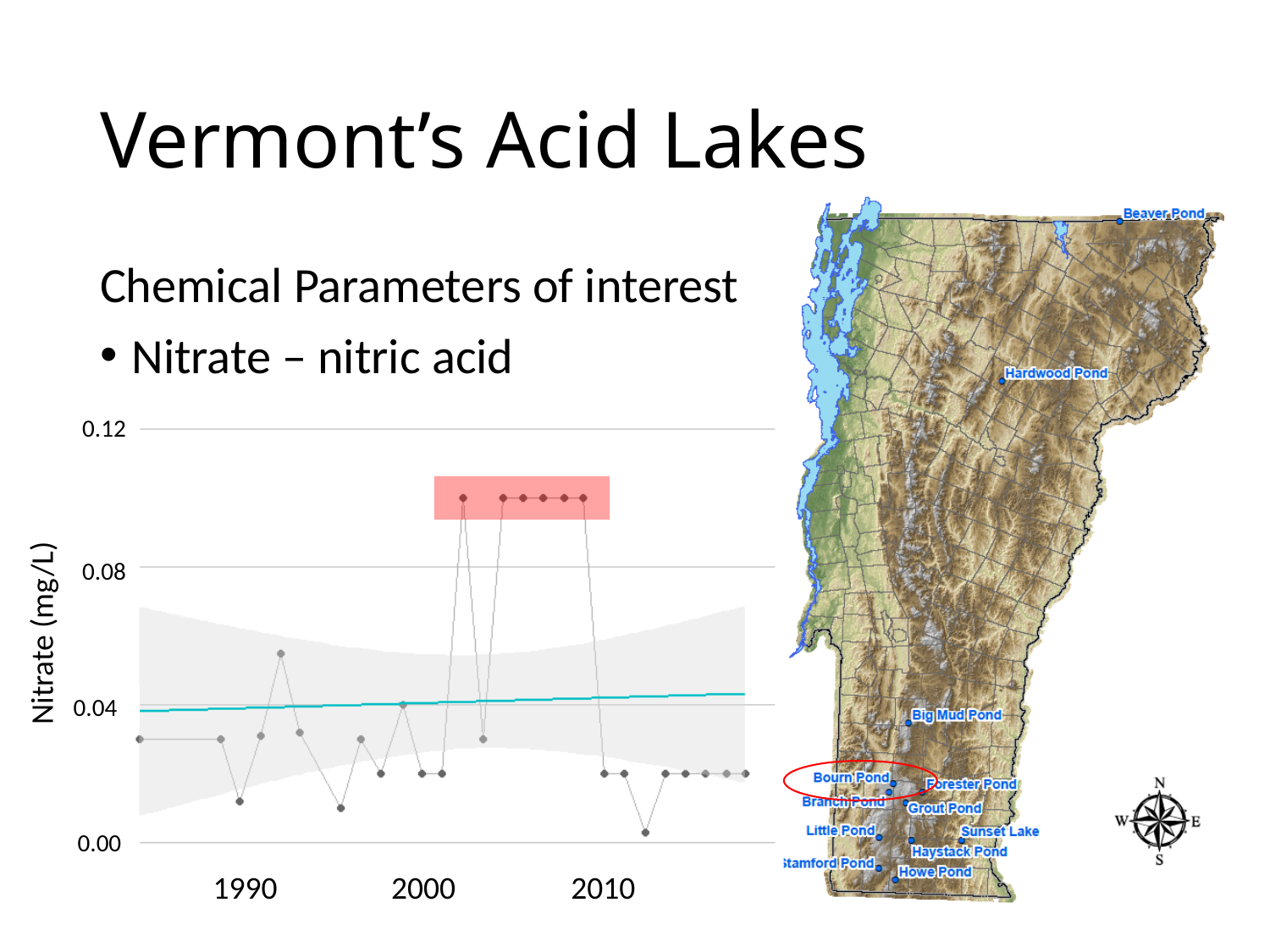
What is the label on the y-axis of the chart? Nitrate (mg/L) Is the highest plotted nitrate value on the chart greater or less than 0.08? greater Is the lowest plotted nitrate value on the chart greater or less than 0.04? less Is the lowest nitrate value plotted shortly after 2010 greater or less than 0.04? less Is the nitrate value plotted around 1996 greater or less than 0.04? less What is the highest value shown on the y-axis of the chart? 0.12 How many data points are inside the red highlighted box on the chart? 6 Which is larger: the nitrate value plotted around 2002 (in the red box) or the value plotted around 1996? the value around 2002 Is the peak nitrate value plotted just after 1990 greater or less than 0.04? greater Does the blue trend line on the chart rise or fall from 1990 to 2010? rise What kind of chart is shown on the slide? line chart